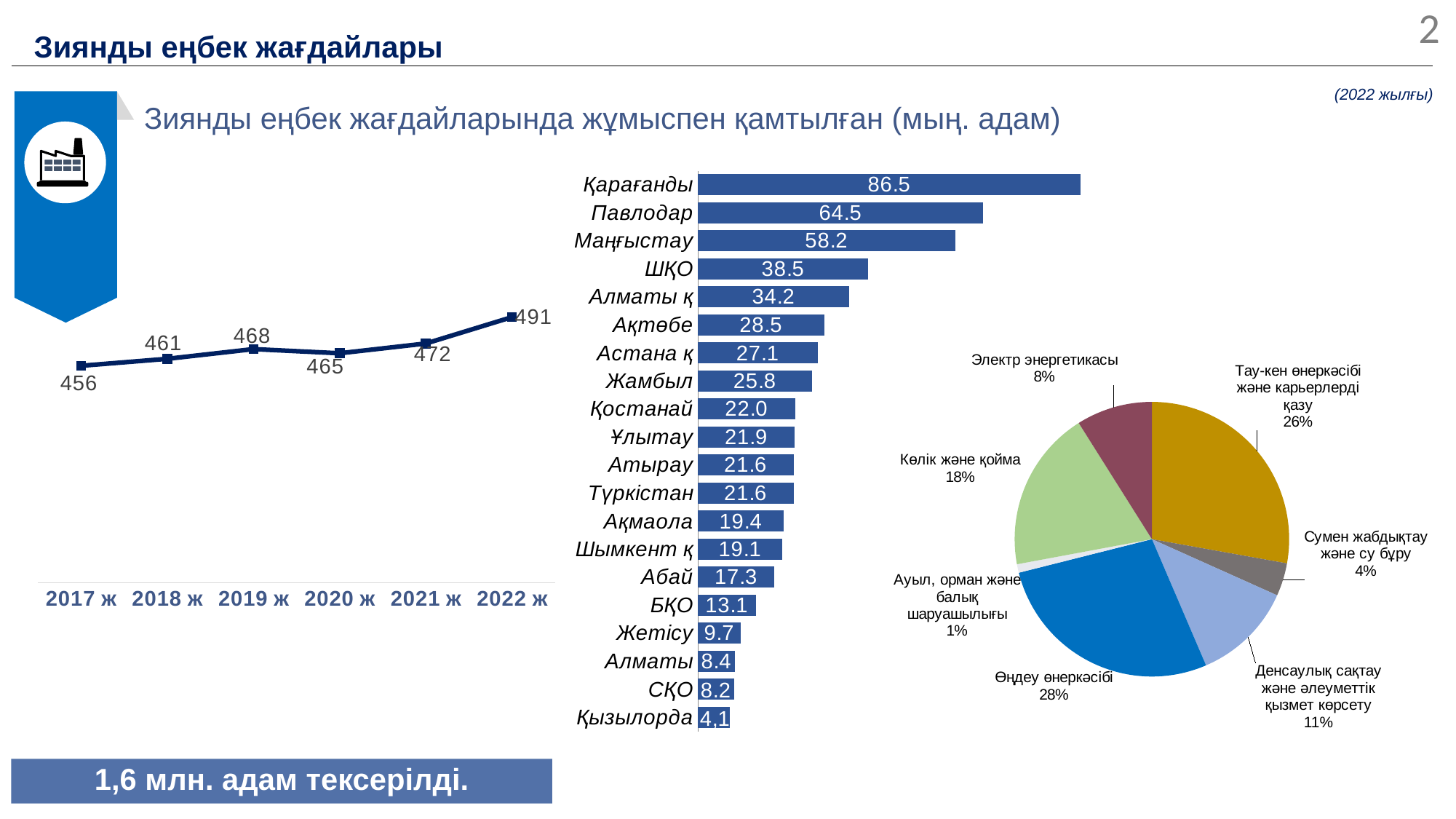
In the horizontal bar chart in the middle, what is the difference between Қарағанды and Маңғыстау? 28.3 In the horizontal bar chart in the middle, which region has the lowest value? Қызылорда In the line chart on the left, what is the difference between the 2022 ж and 2017 ж values? 35 In the line chart on the left, what is the value for 2022 ж? 491 What type of chart is the one in the middle of the slide? Bar chart In the line chart on the left, which year has the lowest value? 2017 ж In the line chart on the left, how many years are plotted? 6 In the horizontal bar chart in the middle, which region has the highest value? Қарағанды In the pie chart on the right, which is larger: Көлік және қойма or Денсаулық сақтау және әлеуметтік қызмет көрсету? Көлік және қойма In the pie chart on the right, what share does Өңдеу өнеркәсібі have? 28% In the horizontal bar chart in the middle, how many regions are shown? 20 In the horizontal bar chart in the middle, what is the value for Павлодар? 64.5